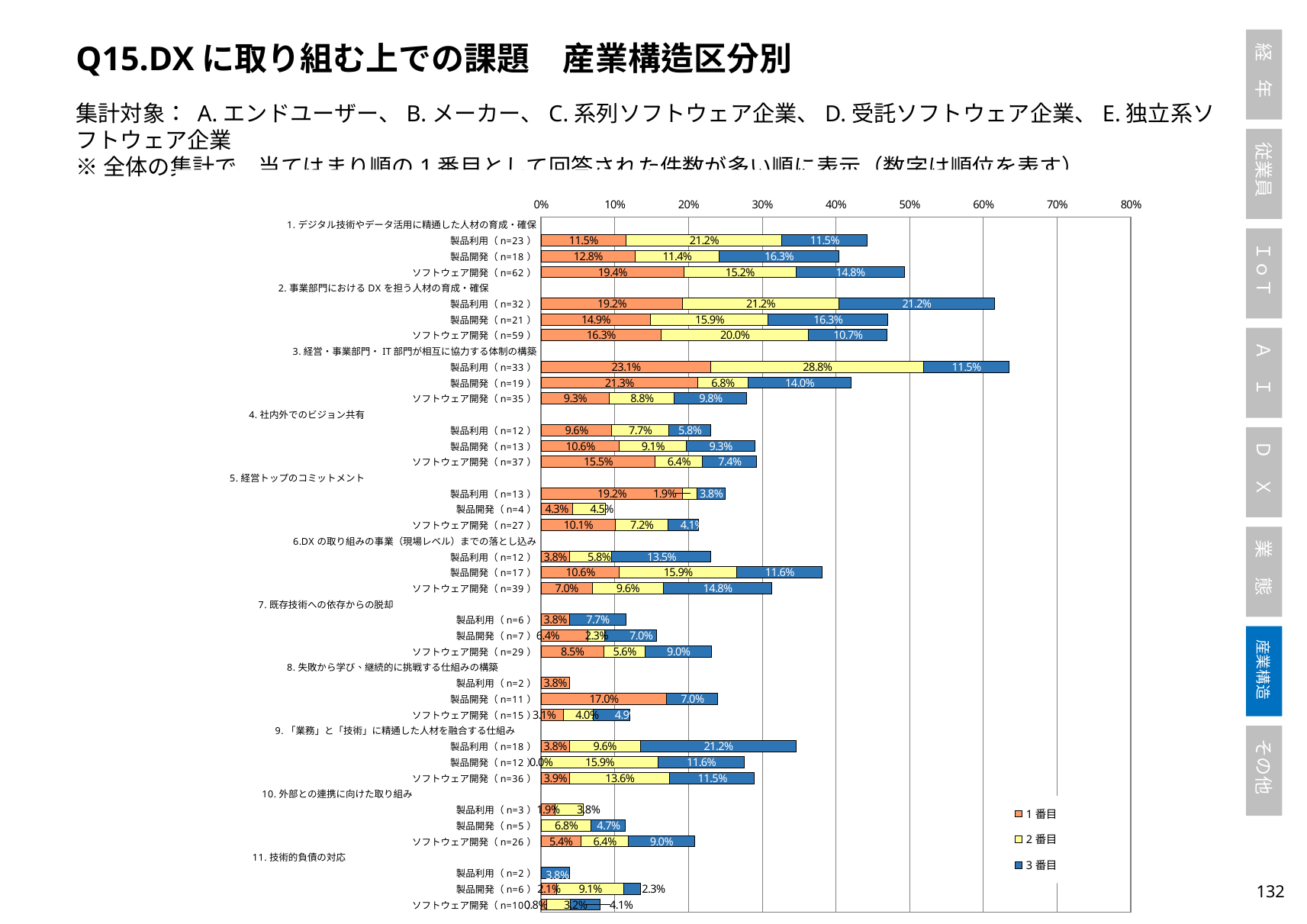
What is the 2番目 value for 製品利用 (n=33) under 3. 経営・事業部門・IT部門が相互に協力する体制の構築? 28.8% What is the difference between the 1番目 values for 製品利用 (n=33) and 製品開発 (n=19) under 3. 経営・事業部門・IT部門が相互に協力する体制の構築? 1.8% What is the total of the stacked bar for 製品利用 (n=23) under 1. デジタル技術やデータ活用に精通した人材の育成・確保? 44.2% What is the 1番目 value for 製品開発 (n=12) under 9. 「業務」と「技術」に精通した人材を融合する仕組み? 0.0% What kind of chart is shown on the slide? Stacked bar chart Which has the larger 3番目 value: 製品利用 (n=18) under 9. 「業務」と「技術」に精通した人材を融合する仕組み, or 製品開発 (n=12) in the same group? 製品利用 (n=18) How many series does the legend list? 3 What is the 3番目 value for ソフトウェア開発 (n=62) under 1. デジタル技術やデータ活用に精通した人材の育成・確保? 14.8% What is the total of the stacked bar for 製品利用 (n=32) under 2. 事業部門におけるDXを担う人材の育成・確保? 61.6% What is the 1番目 value for 製品利用 (n=33) under 3. 経営・事業部門・IT部門が相互に協力する体制の構築? 23.1% Is the total of the stacked bar for 製品利用 (n=33) under 3. 経営・事業部門・IT部門が相互に協力する体制の構築 greater or less than 60%? greater What are the three legend entries? 1番目, 2番目, 3番目